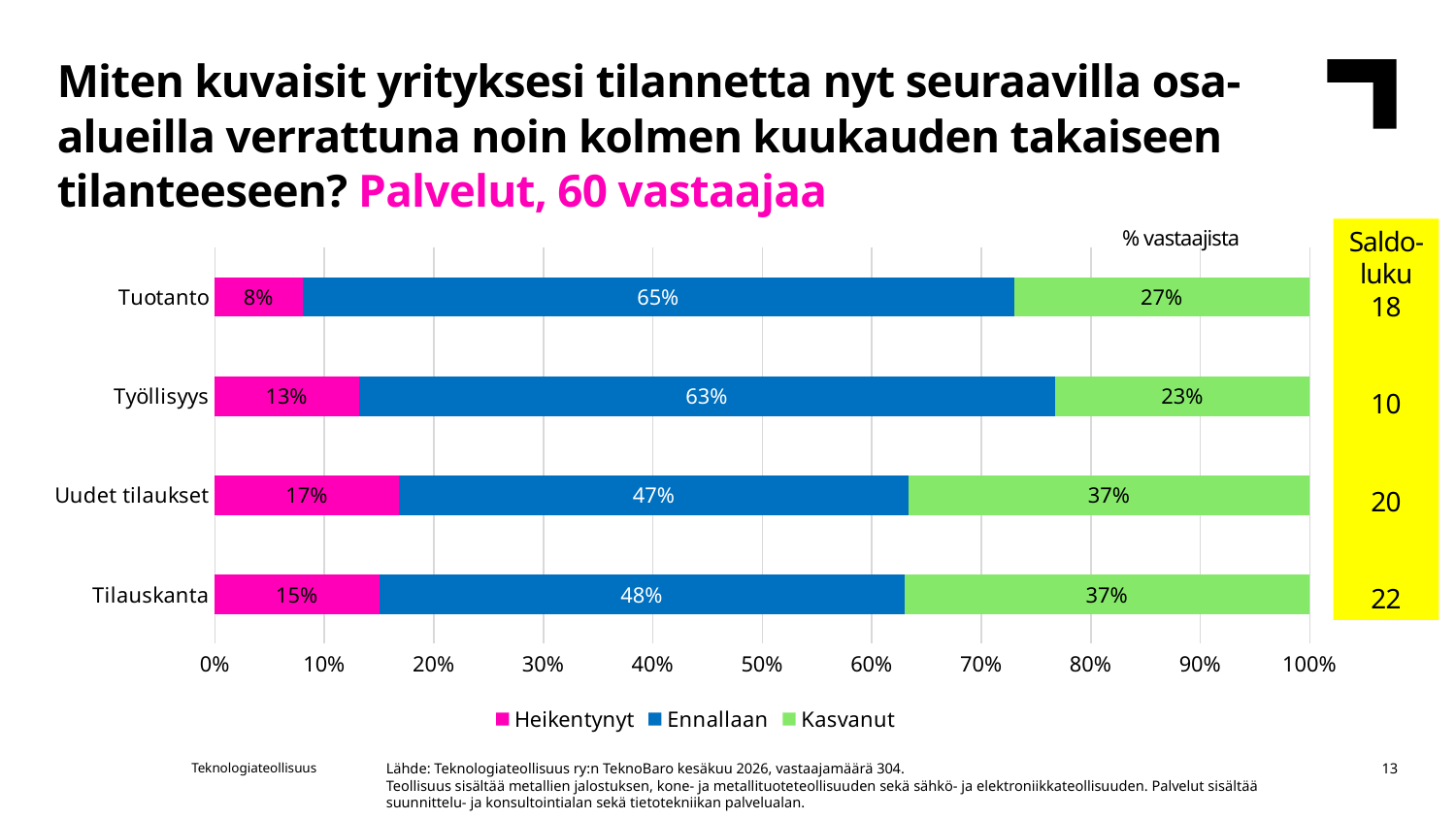
How many categories are plotted on the chart? 4 Which is larger, the Heikentynyt value for Työllisyys or for Tilauskanta? Tilauskanta What is the Ennallaan value for Tuotanto? 65% Which legend entry is shown in green? Kasvanut What is the Heikentynyt value for Uudet tilaukset? 17% What kind of chart is shown on the slide? Stacked bar chart What is the total of the stacked bar for Tilauskanta? 100% What is the difference between the Kasvanut values for Uudet tilaukset and Tuotanto? 10% How many series does the legend list? 3 Which category has the highest Ennallaan value? Tuotanto Which category has the lowest Heikentynyt value? Tuotanto What is the Kasvanut value for Työllisyys? 23%